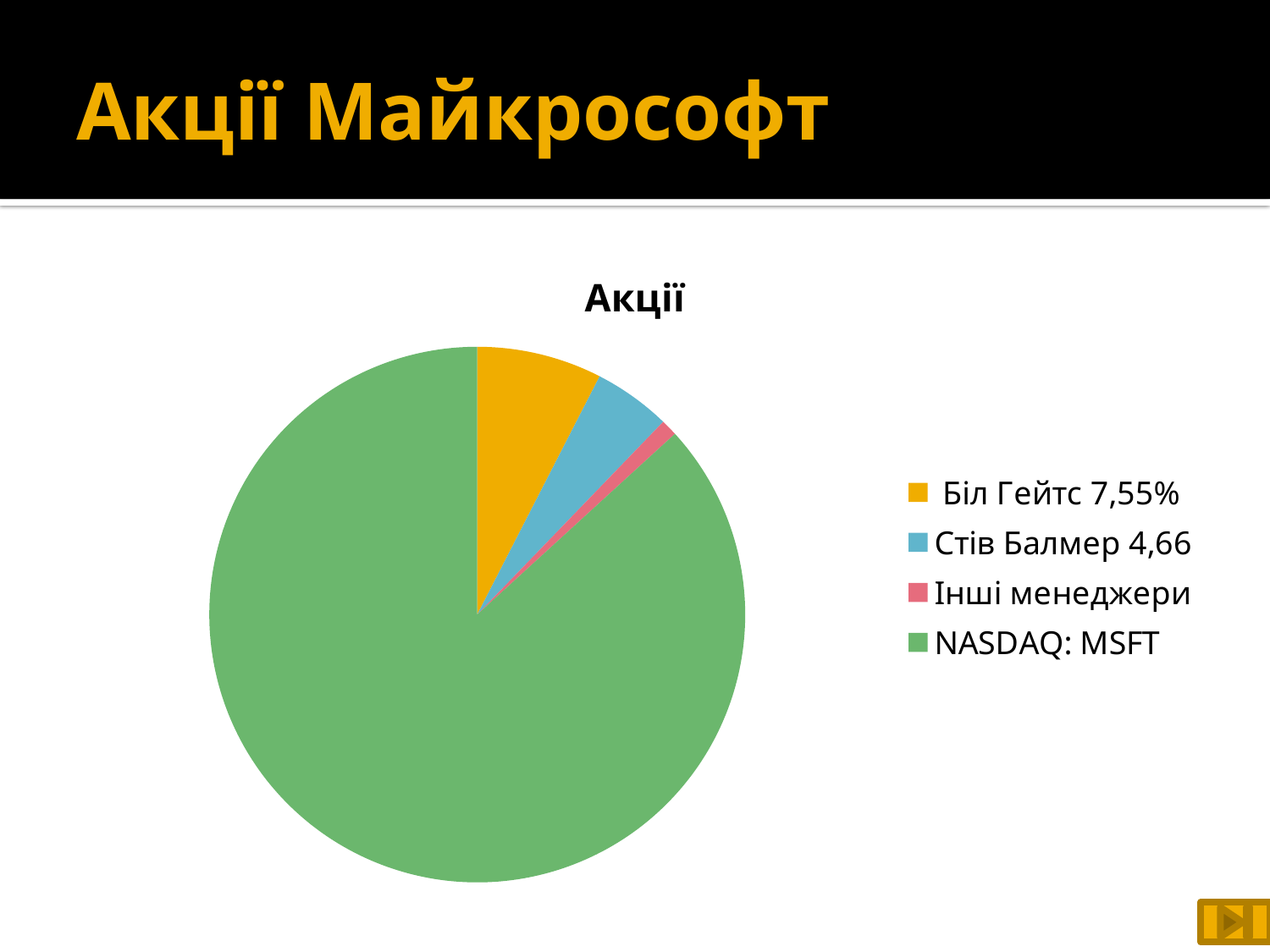
What is the title of the chart? Акції Which category has the smallest slice of the pie? Інші менеджери What value is printed in the legend for Стів Балмер? 4,66 Which slice is larger, Біл Гейтс or Стів Балмер? Біл Гейтс What kind of chart is shown on the slide? pie chart Which slice is larger, NASDAQ: MSFT or Біл Гейтс? NASDAQ: MSFT What percentage is printed in the legend for Біл Гейтс? 7,55% Which slice is larger, Стів Балмер or Інші менеджери? Стів Балмер How many slices does the pie chart have? 4 Which category has the largest slice of the pie? NASDAQ: MSFT What colour is the NASDAQ: MSFT slice? green